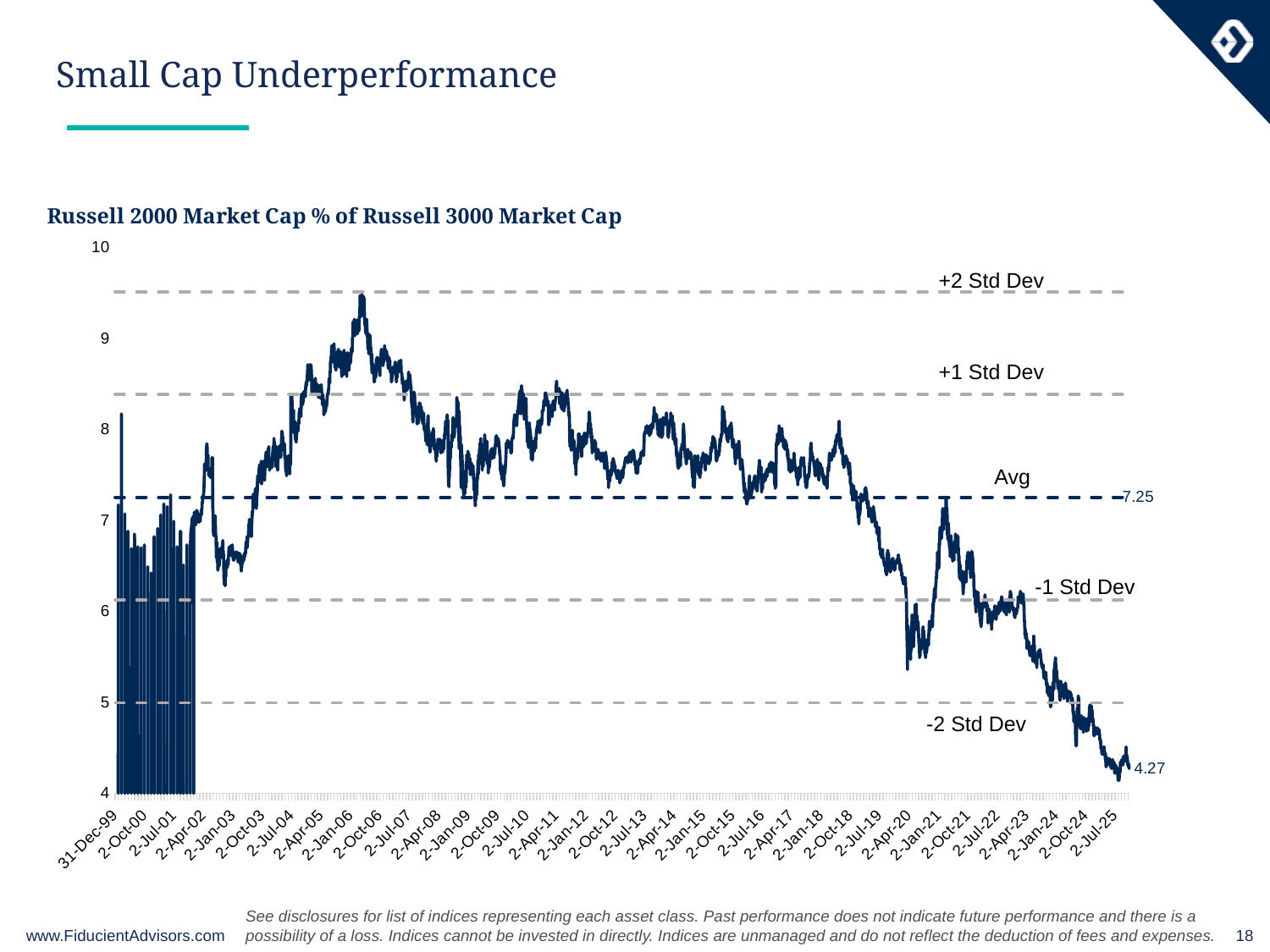
What kind of chart is shown on the slide? line chart What is the highest tick shown on the y axis? 10 Is the value around 2-Apr-20 greater or less than 6? less Which is larger, the value around 2-Jan-06 or the value at 2-Jul-25? 2-Jan-06 What is the difference between the Avg value and the final value of 4.27? 2.98 Is the value around 2-Jan-24 greater or less than 6? less Is the final value of the series greater or less than the Avg of 7.25? less What is the title of the chart? Russell 2000 Market Cap % of Russell 3000 Market Cap Does the series rise or fall from 2-Jan-18 to 2-Jul-25? fall Is the value around 2-Jan-06 greater or less than 9? greater What value is printed for the Avg line? 7.25 What is the last value printed at the end of the line (2-Jul-25)? 4.27